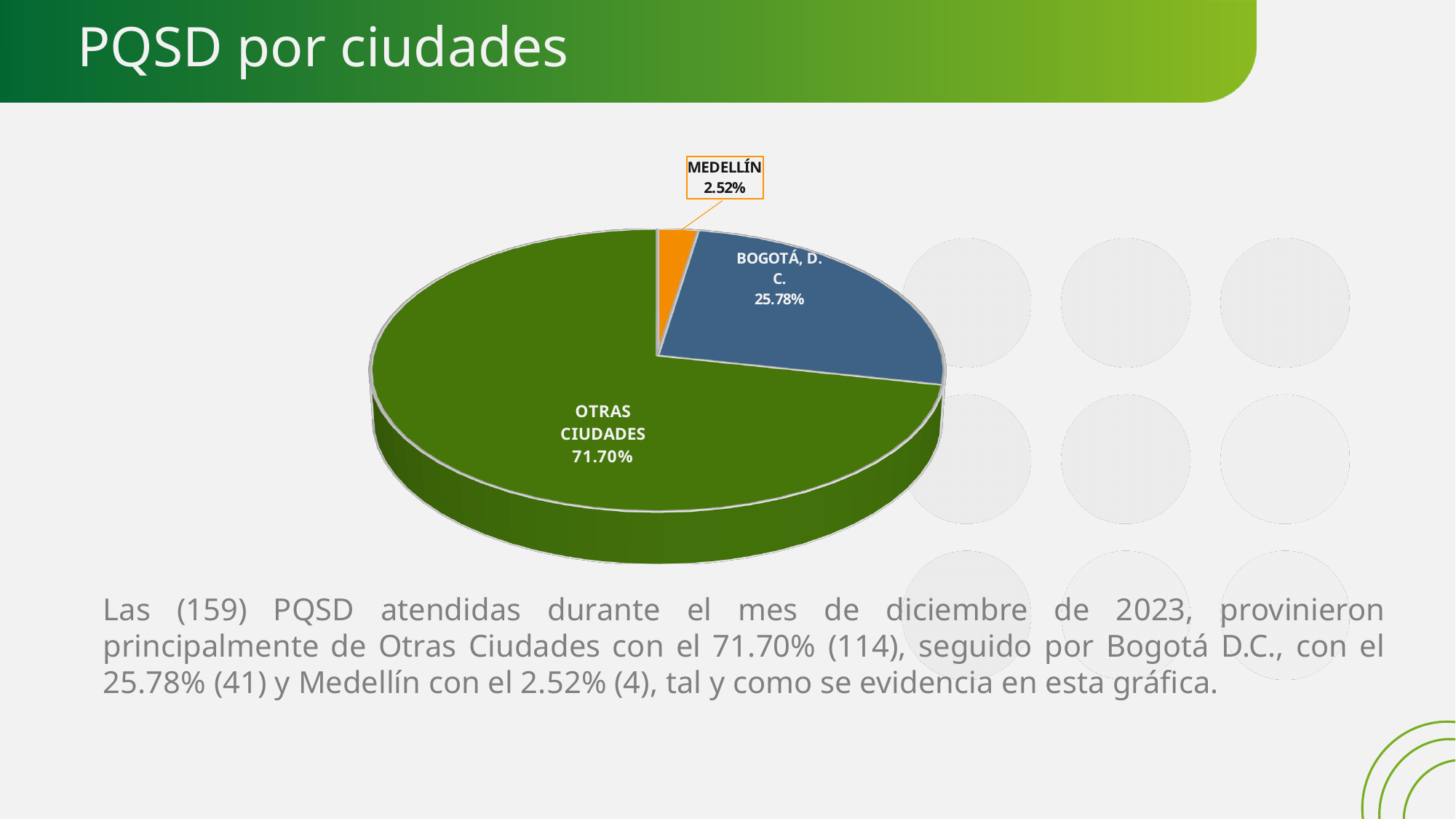
Which slice of the pie is the largest? OTRAS CIUDADES What share of the pie does MEDELLÍN represent? 2.52% What kind of chart is shown on the slide? pie chart How many slices does the pie chart have? 3 What is the difference in percentage points between OTRAS CIUDADES and BOGOTÁ, D. C.? 45.92 What is the difference in percentage points between BOGOTÁ, D. C. and MEDELLÍN? 23.26 What share of the pie does OTRAS CIUDADES represent? 71.70% Which is larger, the share for BOGOTÁ, D. C. or the share for MEDELLÍN? BOGOTÁ, D. C. Which slice of the pie is the smallest? MEDELLÍN What share of the pie does BOGOTÁ, D. C. represent? 25.78% What is the title of the slide containing the chart? PQSD por ciudades What colour is the OTRAS CIUDADES slice? green